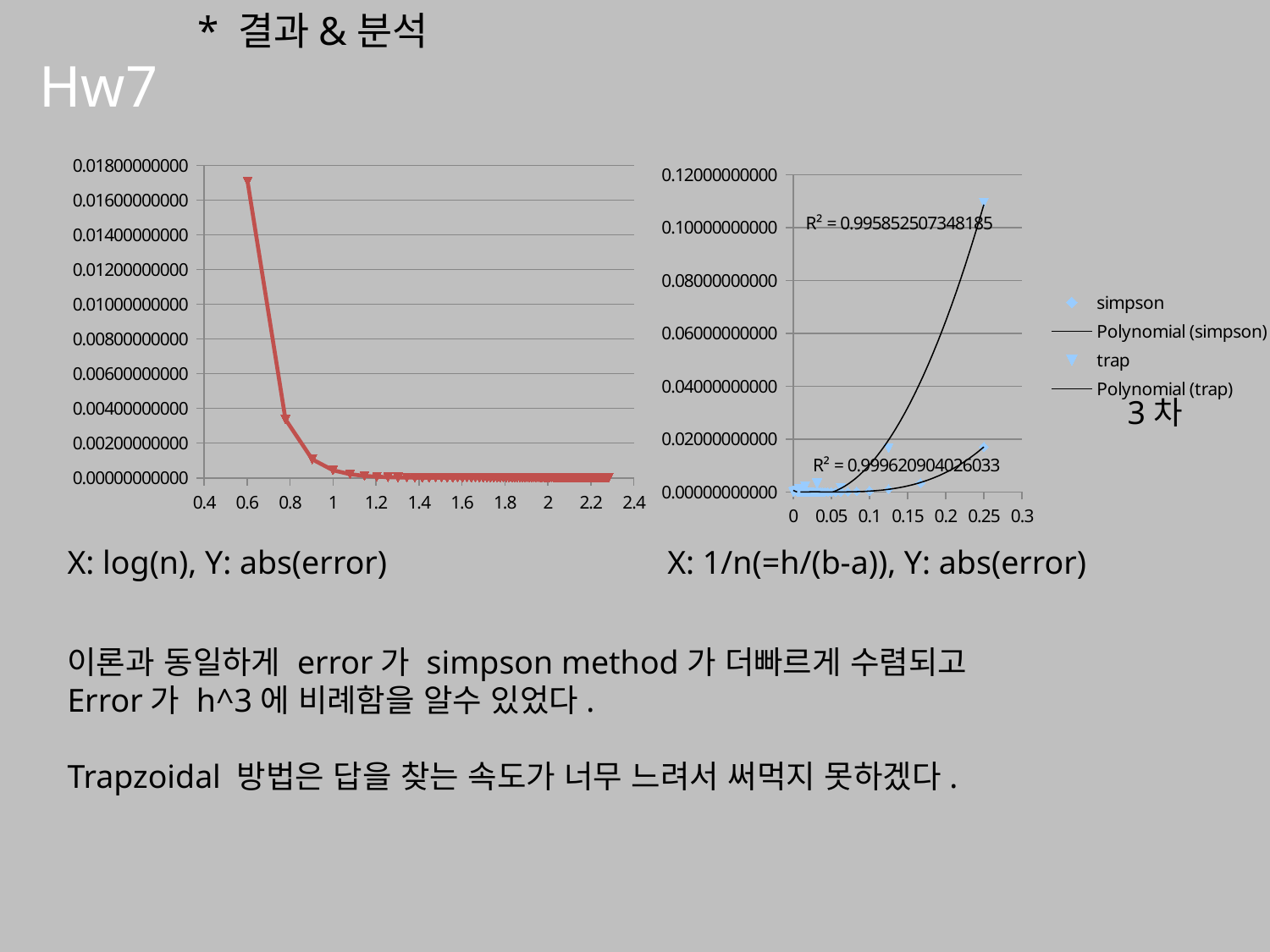
In the left chart (X: log(n), Y: abs(error)), is the value at x = 0.6 greater or less than 0.016? greater In the right chart (X: 1/n, Y: abs(error)), is the simpson value at x = 0.25 greater or less than 0.04? less How many series does the legend of the right chart (X: 1/n, Y: abs(error)) list? 4 What kind of chart is the left chart (X: log(n), Y: abs(error))? line chart What is the highest y-axis tick label on the left chart (X: log(n), Y: abs(error))? 0.01800000000 In the left chart (X: log(n), Y: abs(error)), do the values rise or fall as x increases? fall In the right chart (X: 1/n, Y: abs(error)), at x = 0.25 which series has the larger error, simpson or trap? trap What is the lower R² value printed on the right chart (X: 1/n, Y: abs(error))? R² = 0.999620904026033 What are the legend entries of the right chart (X: 1/n, Y: abs(error))? simpson, Polynomial (simpson), trap, Polynomial (trap) In the left chart (X: log(n), Y: abs(error)), is the value at x = 0.8 greater or less than 0.006? less What is the upper R² value printed on the right chart (X: 1/n, Y: abs(error))? R² = 0.995852507348185